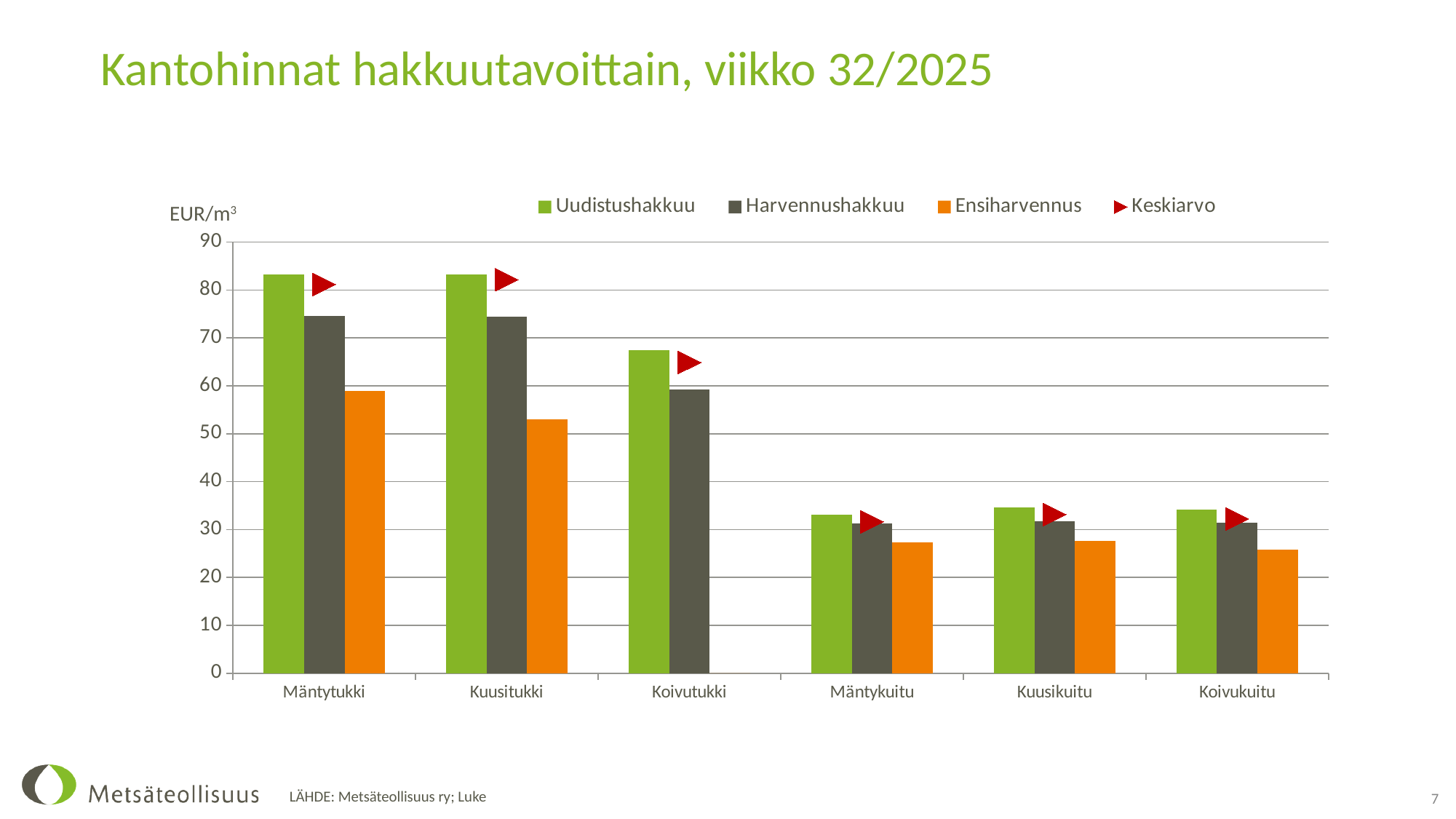
Is the Ensiharvennus value for Kuusitukki greater or less than 50? greater Which category has the highest Ensiharvennus value? Mäntytukki What unit is shown on the y axis of the chart? EUR/m³ Is the Uudistushakkuu value for Mäntytukki greater or less than 80? greater How many categories are shown on the x axis? 6 Is the Ensiharvennus value for Mäntykuitu greater or less than 30? less Which is larger, the Ensiharvennus value for Mäntytukki or for Kuusitukki? Mäntytukki What kind of chart is shown on the slide? Bar chart How many series does the legend list? 4 Which is larger, the Uudistushakkuu value for Mäntytukki or for Koivutukki? Mäntytukki